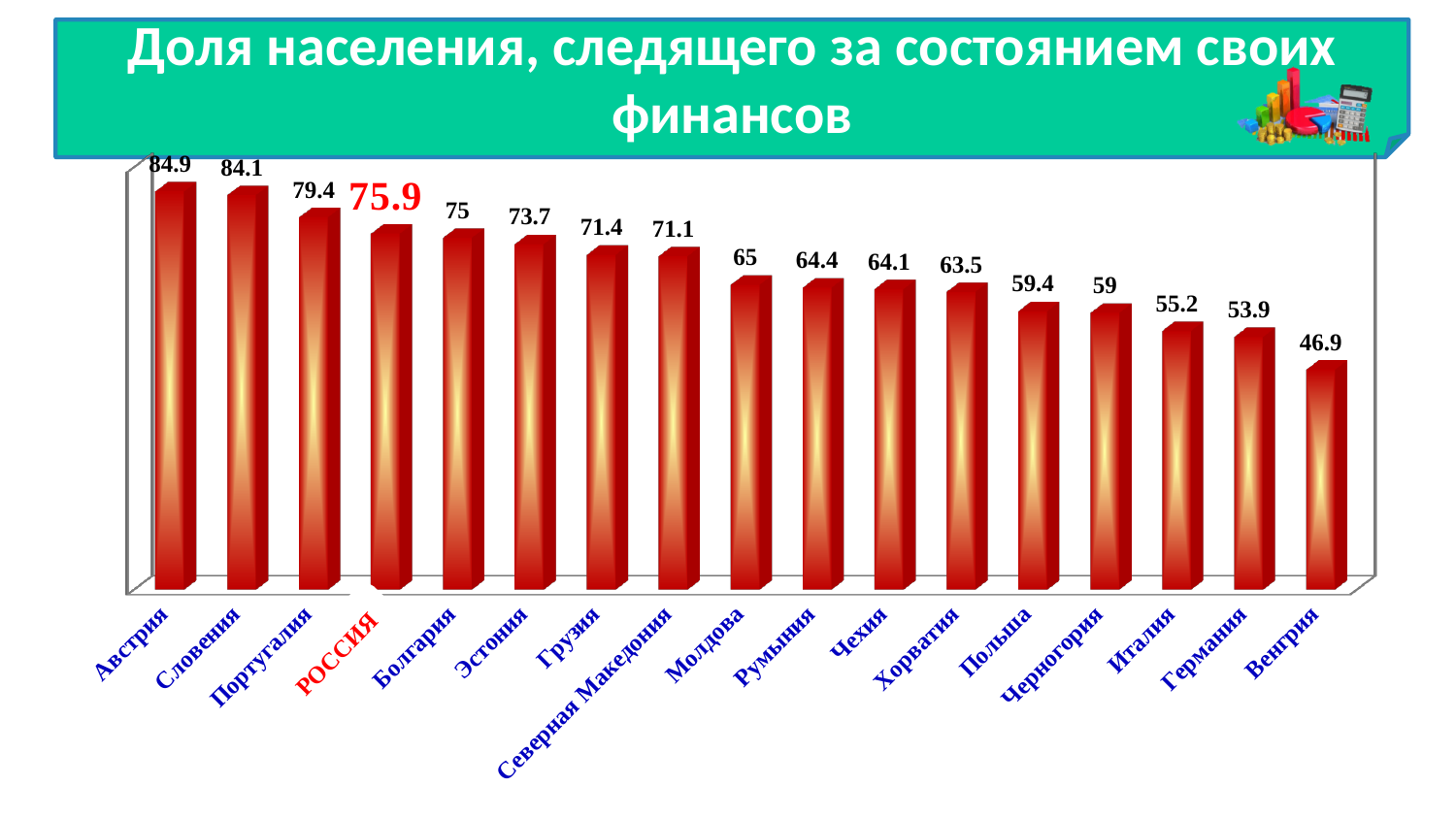
What is the value for РОССИЯ? 75.9 How many countries are shown in the chart? 17 What is the value for Северная Македония? 71.1 What is the value for Венгрия? 46.9 Which country has the lowest value? Венгрия Which has a larger value, Португалия or Польша? Португалия Do the values rise or fall from left to right along the x axis? Fall What is the difference between the values for Австрия and Венгрия? 38 What kind of chart is shown on the slide? Bar chart What is the value for Австрия? 84.9 Which country has the highest value? Австрия What is the difference between the values for РОССИЯ and Германия? 22